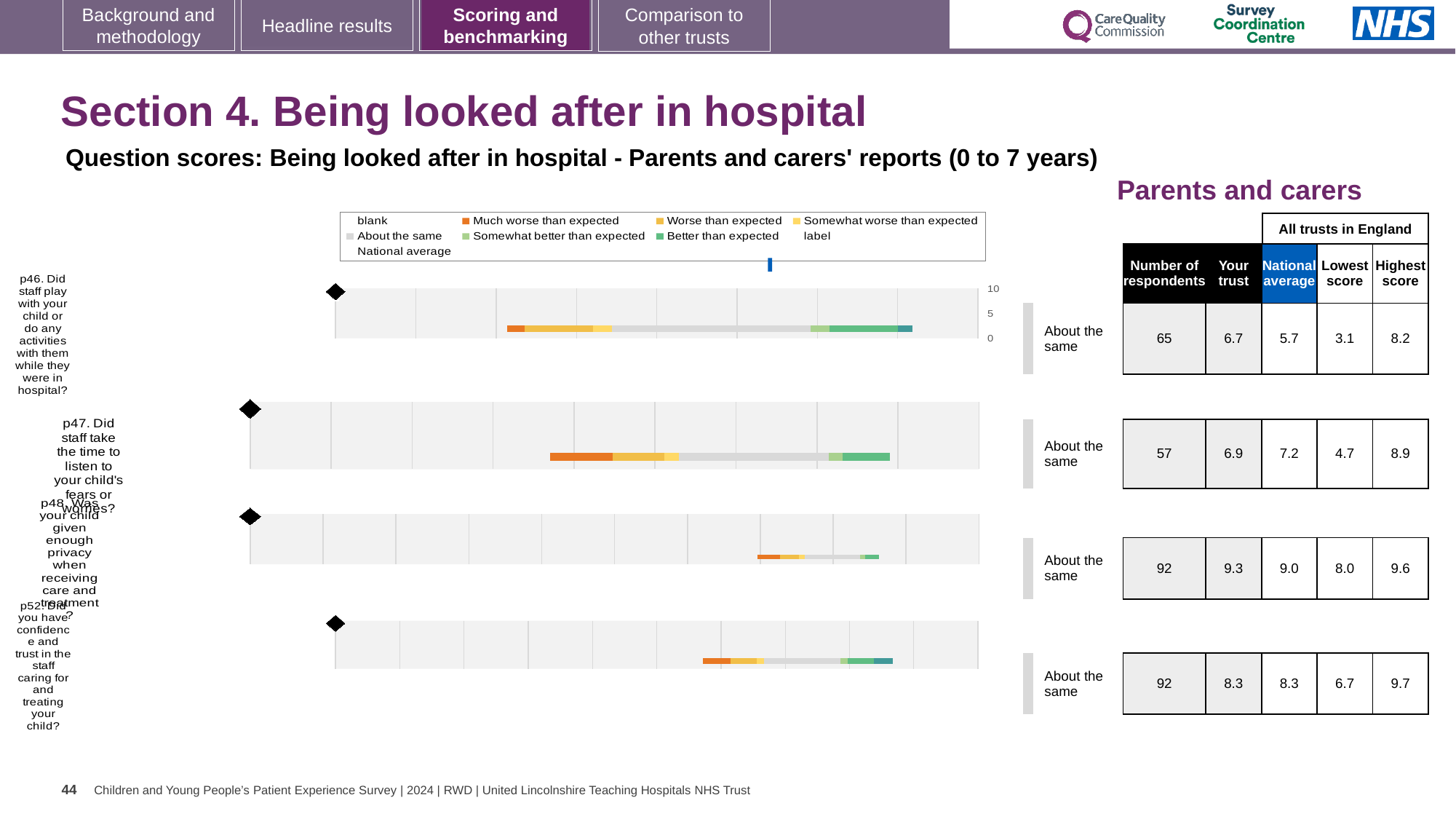
What is the lowest score among all trusts in England for p52 (Did you have confidence and trust in the staff caring for and treating your child)? 6.7 What kind of chart is used to show the question scores? Bar chart What is the highest score among all trusts in England for p47? 8.9 For p46, what is the difference between the 'Your trust' score and the national average? 1.0 What benchmark category is shown for p52? About the same Which question has the lowest 'Your trust' score? p46 What is the 'Your trust' score for p47 (Did staff take the time to listen to your child's fears or worries)? 6.9 How many questions are plotted on the chart? 4 What is the national average score for p48 (Was your child given enough privacy when receiving care and treatment)? 9.0 Which question has the highest 'Your trust' score? p48 How many respondents answered question p46 (Did staff play with your child or do any activities with them while they were in hospital)? 65 For p47, which is larger: the 'Your trust' score or the national average? National average